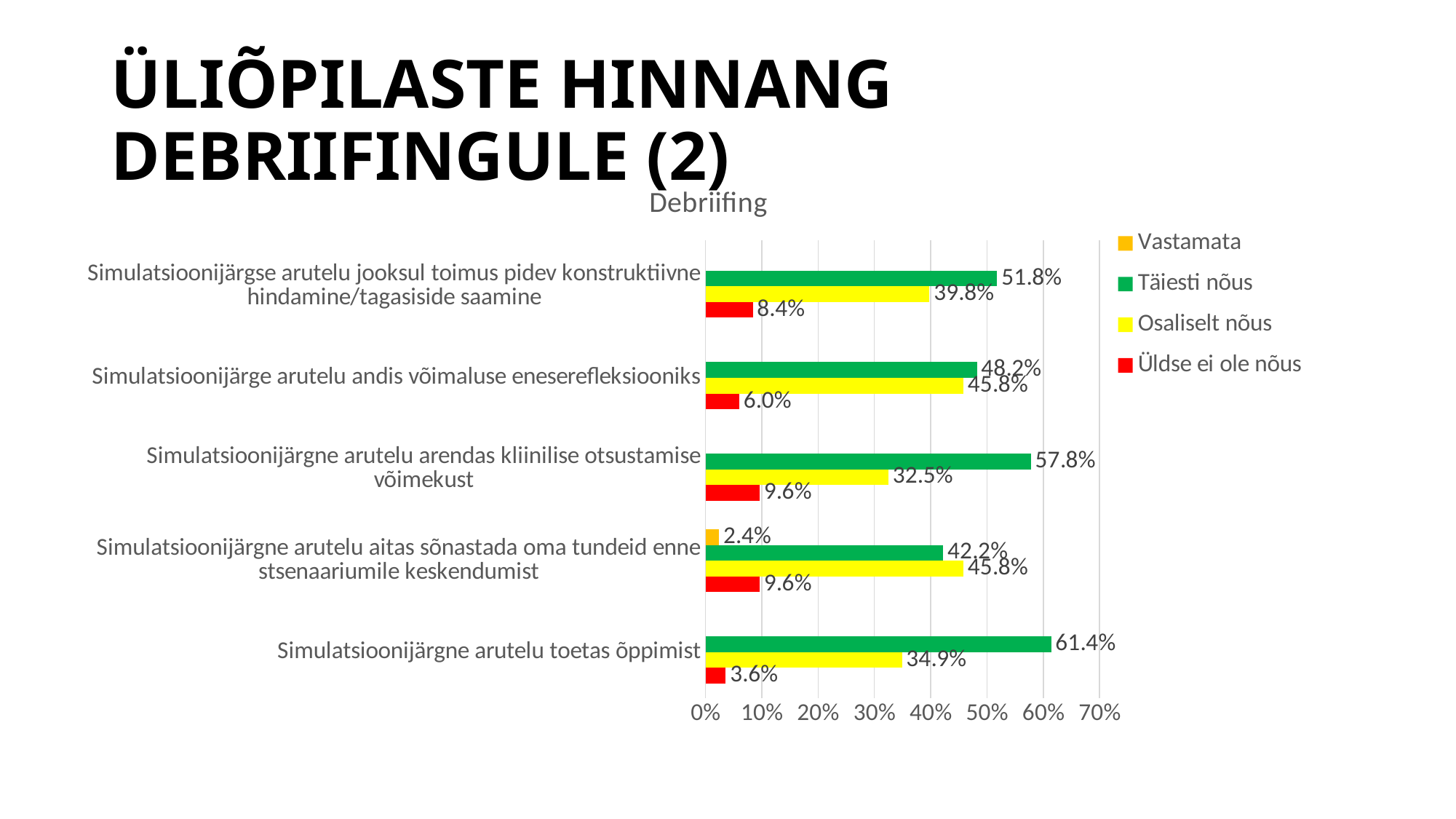
Which statement has the lowest 'Üldse ei ole nõus' value? Simulatsioonijärgne arutelu toetas õppimist What is the 'Vastamata' value for 'Simulatsioonijärgne arutelu aitas sõnastada oma tundeid enne stsenaariumile keskendumist'? 2.4% How many series does the legend list? 4 What kind of chart is shown on the slide? bar chart What is the 'Üldse ei ole nõus' value for 'Simulatsioonijärge arutelu andis võimaluse enesereflektsiooniks'? 6.0% What is the difference between the 'Täiesti nõus' and 'Osaliselt nõus' values for 'Simulatsioonijärgse arutelu jooksul toimus pidev konstruktiivne hindamine/tagasiside saamine'? 12.0% What is the 'Täiesti nõus' value for 'Simulatsioonijärgne arutelu toetas õppimist'? 61.4% For 'Simulatsioonijärgne arutelu aitas sõnastada oma tundeid enne stsenaariumile keskendumist', which is larger: 'Täiesti nõus' or 'Osaliselt nõus'? Osaliselt nõus Which statement has the highest 'Täiesti nõus' value? Simulatsioonijärgne arutelu toetas õppimist How many categories (statements) are shown on the chart? 5 What is the 'Osaliselt nõus' value for 'Simulatsioonijärgne arutelu arendas kliinilise otsustamise võimekust'? 32.5% What is the title of the chart? Debriifing